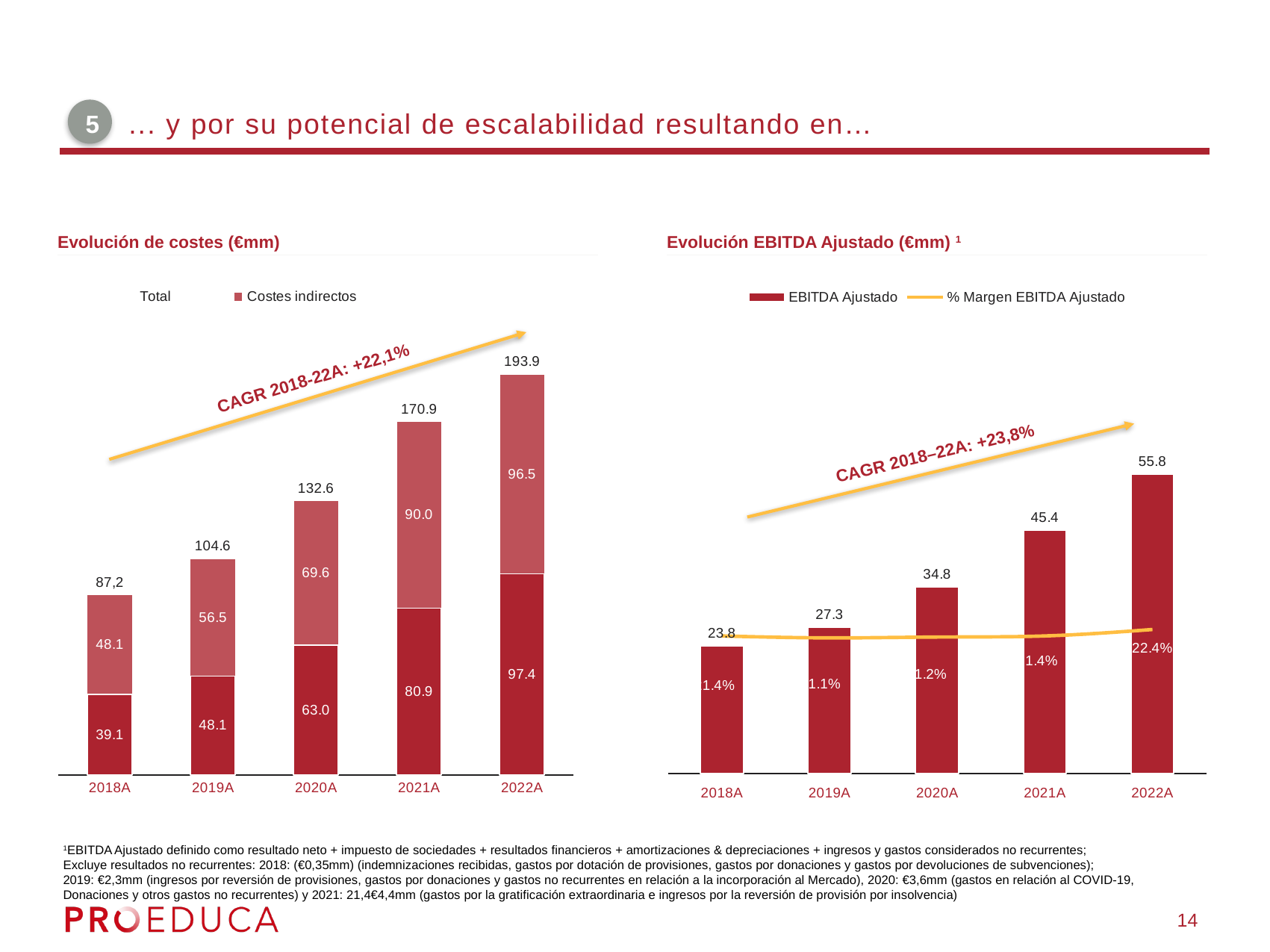
What kind of chart is the 'Evolución de costes (€mm)' chart on the left? Stacked bar chart In the 'Evolución de costes (€mm)' chart, do the totals rise or fall from 2018A to 2022A? Rise In the 'Evolución de costes (€mm)' chart, what CAGR for 2018-22A is written above the bars? +22,1% In the 'Evolución de costes (€mm)' chart, what is the value of Costes indirectos for 2020A? 69.6 In the 'Evolución EBITDA Ajustado (€mm)' chart, which year has the lowest EBITDA Ajustado? 2018A How many series does the legend of the 'Evolución EBITDA Ajustado (€mm)' chart list? 2 In the 'Evolución de costes (€mm)' chart, what is the difference between the totals for 2022A and 2021A? 23.0 In the 'Evolución EBITDA Ajustado (€mm)' chart, what is the EBITDA Ajustado value for 2020A? 34.8 How many years are shown on the x axis of the 'Evolución de costes (€mm)' chart? 5 In the 'Evolución EBITDA Ajustado (€mm)' chart, what is the difference between EBITDA Ajustado in 2022A and 2018A? 32.0 In the 'Evolución de costes (€mm)' chart, what is the total value for 2022A? 193.9 In the 'Evolución de costes (€mm)' chart, which year has the highest total? 2022A